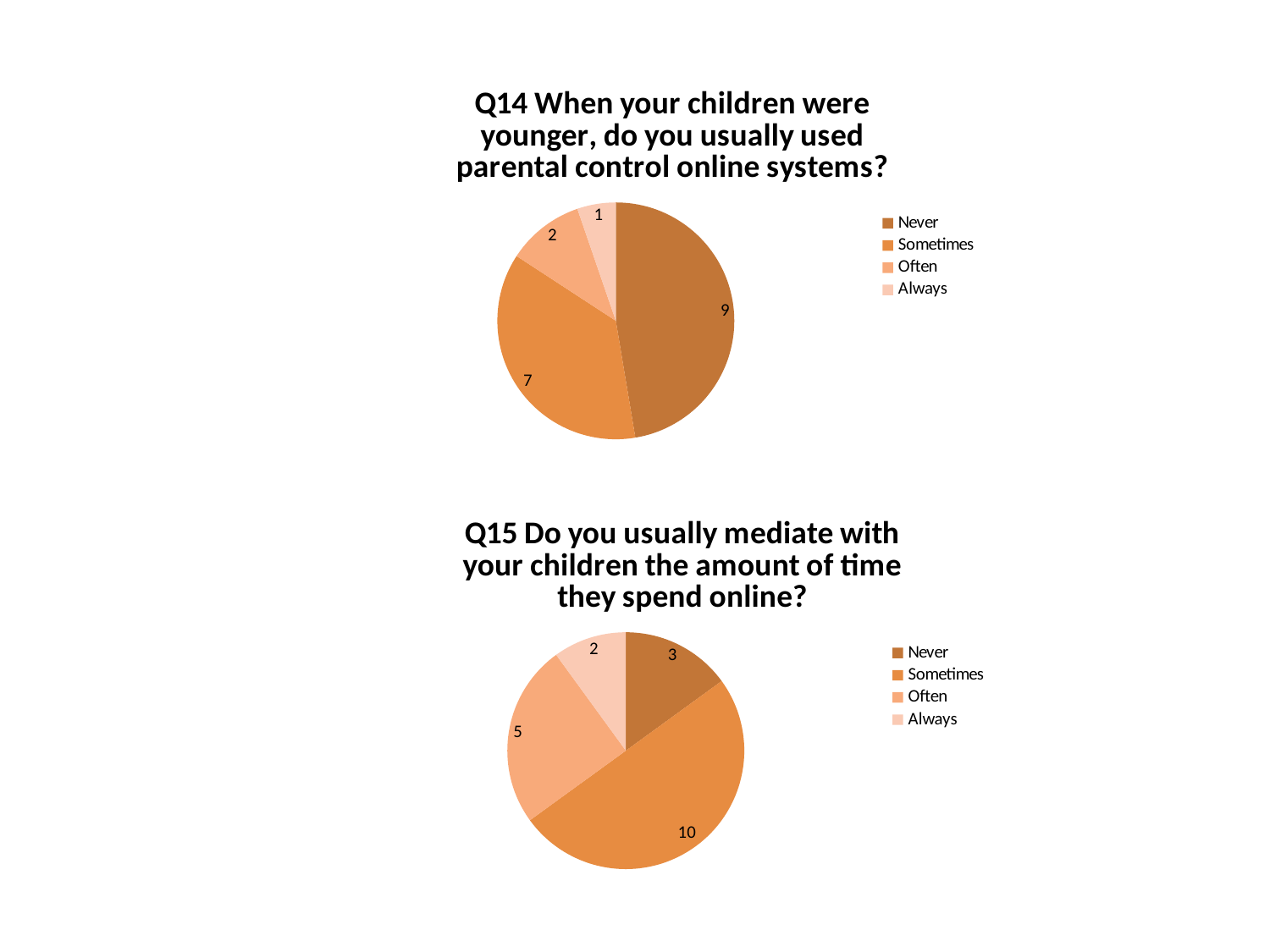
What is the total number of responses shown in the Q14 chart? 19 What kind of chart is used for Q14? Pie chart In the Q15 chart, what share of the total does "Sometimes" represent? 50% How many categories does the Q15 chart show? 4 In the Q14 chart, how many respondents answered "Always"? 1 In the Q14 chart, how many respondents answered "Never"? 9 In the Q15 chart, how many respondents answered "Often"? 5 In the Q15 chart, which is larger, "Never" or "Often"? Often In the Q15 chart, how many respondents answered "Sometimes"? 10 In the Q15 chart, which category has the smallest slice? Always In the Q14 chart, what is the difference between the "Never" and "Sometimes" counts? 2 In the Q14 chart, which category has the largest slice? Never